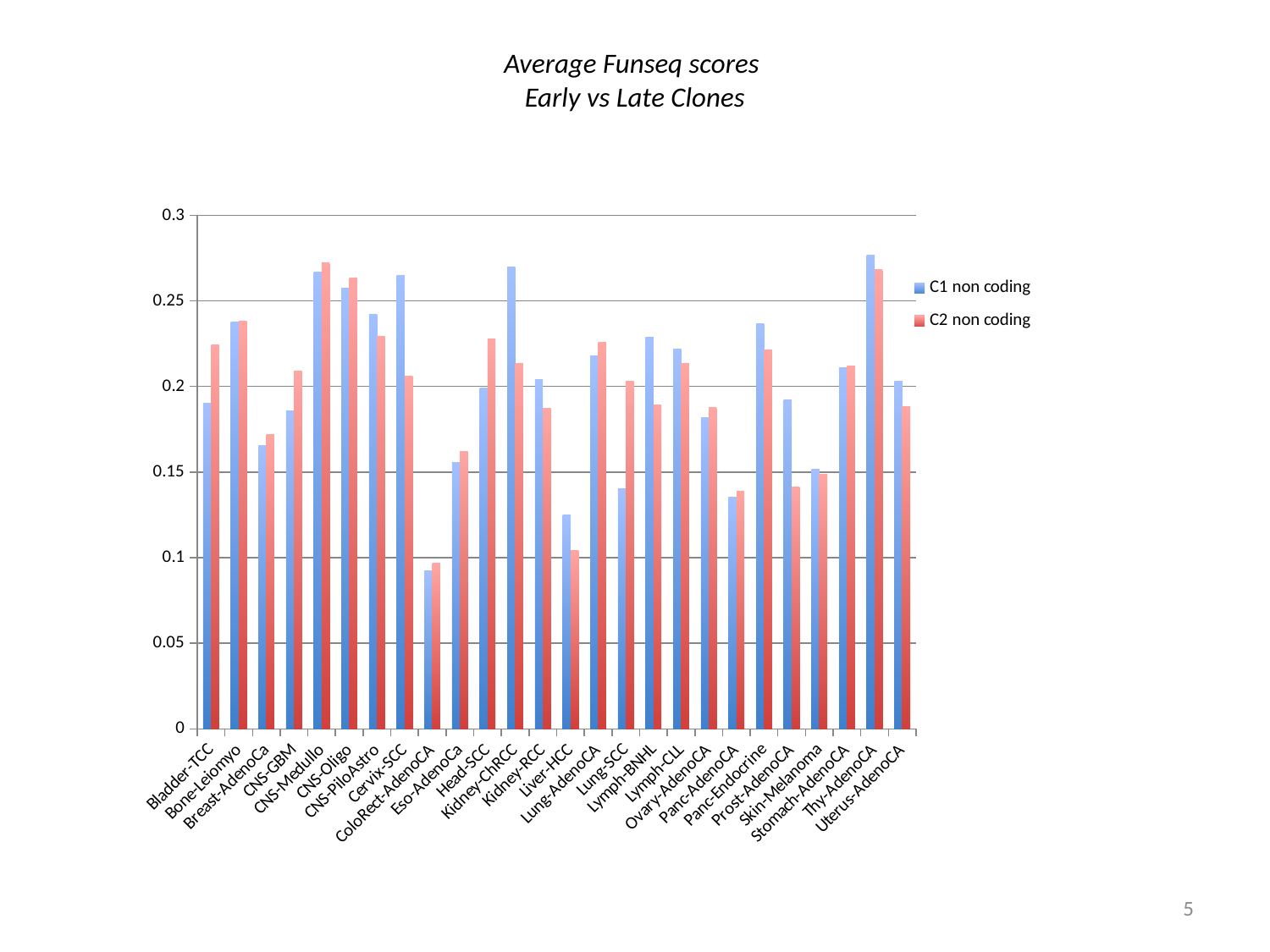
What is the title of the chart? Average Funseq scores Early vs Late Clones Which category has the highest C1 non coding value? Thy-AdenoCA For Head-SCC, which series has the larger value, C1 non coding or C2 non coding? C2 non coding Is the C2 non coding value for Bladder-TCC greater or less than 0.2? greater Which category has the lowest C1 non coding value? ColoRect-AdenoCA How many series does the legend list? 2 What kind of chart is shown on the slide? bar chart Is the C1 non coding value for Liver-HCC greater or less than 0.15? less How many cancer-type categories are shown on the x axis? 26 Is the C1 non coding value for Kidney-ChRCC greater or less than 0.25? greater For Cervix-SCC, which series has the larger value, C1 non coding or C2 non coding? C1 non coding